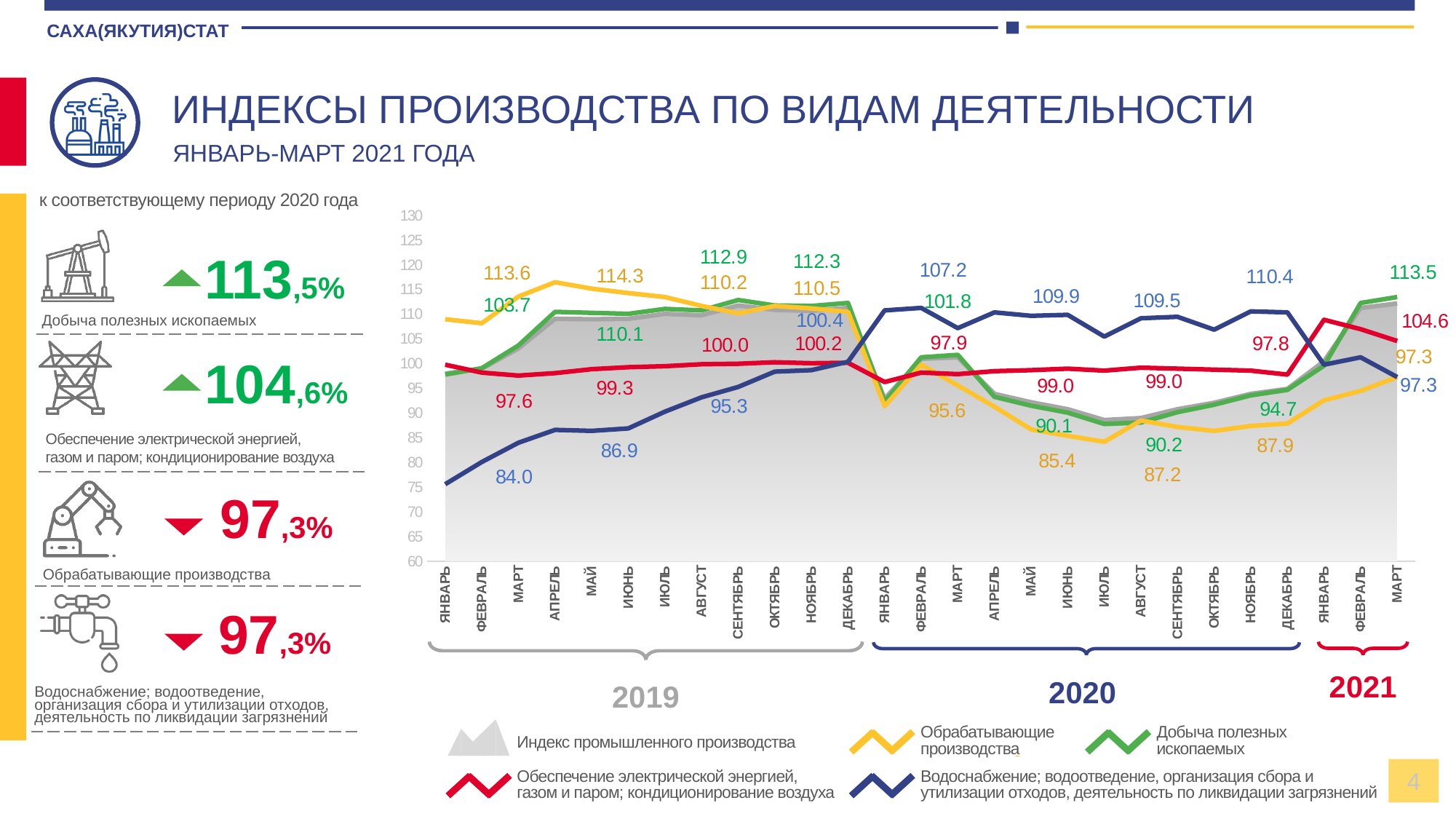
How many series does the chart legend list? 5 Is the value of the Водоснабжение line for January 2019 greater or less than 80? less What is the value of the Обрабатывающие производства line for March 2021? 97.3 How many monthly points are shown along the x axis of the chart? 27 What is the lowest data label shown on the Обрабатывающие производства line? 85.4 Which series has the highest value at March 2021? Добыча полезных ископаемых What is the difference between the March 2021 values of Добыча полезных ископаемых and Обеспечение электрической энергией, газом и паром? 8.9 What is the value of the Добыча полезных ископаемых line for March 2021? 113.5 What is the value of the Обеспечение электрической энергией, газом и паром line for March 2021? 104.6 Does the Водоснабжение line rise or fall across the months of 2019? rises What kind of chart is shown on the slide? combination area and line chart At March 2021, which is larger: the Добыча полезных ископаемых value or the Обеспечение электрической энергией value? Добыча полезных ископаемых